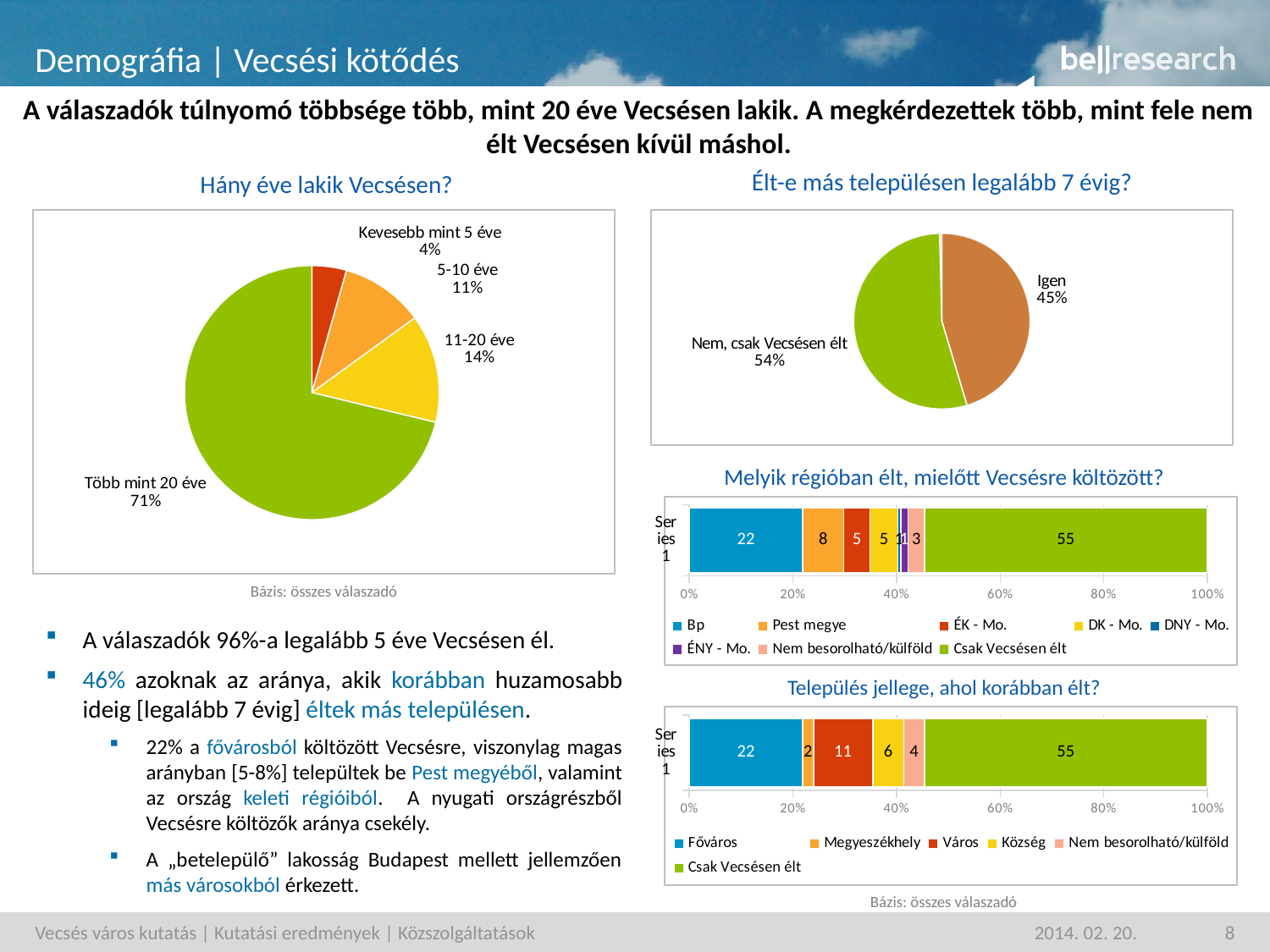
In the chart 'Hány éve lakik Vecsésen?', what share of respondents have lived in Vecsés for more than 20 years (Több mint 20 éve)? 71% In the chart 'Melyik régióban élt, mielőtt Vecsésre költözött?', which series has the largest segment? Csak Vecsésen élt What type of chart is 'Melyik régióban élt, mielőtt Vecsésre költözött?'? Stacked bar chart In the chart 'Település jellege, ahol korábban élt?', what is the value for 'Város'? 11 How many slices does the pie chart 'Hány éve lakik Vecsésen?' have? 4 In the chart 'Hány éve lakik Vecsésen?', what is the difference between the shares for '11-20 éve' and '5-10 éve'? 3 percentage points In the chart 'Élt-e más településen legalább 7 évig?', which is larger: 'Igen' or 'Nem, csak Vecsésen élt'? Nem, csak Vecsésen élt In the chart 'Élt-e más településen legalább 7 évig?', what is the share for 'Igen'? 45% In the chart 'Település jellege, ahol korábban élt?', what is the difference between the values for 'Főváros' and 'Község'? 16 In the chart 'Melyik régióban élt, mielőtt Vecsésre költözött?', what is the value for 'Pest megye'? 8 How many series does the legend of the chart 'Melyik régióban élt, mielőtt Vecsésre költözött?' list? 8 In the chart 'Hány éve lakik Vecsésen?', which category has the smallest share? Kevesebb mint 5 éve